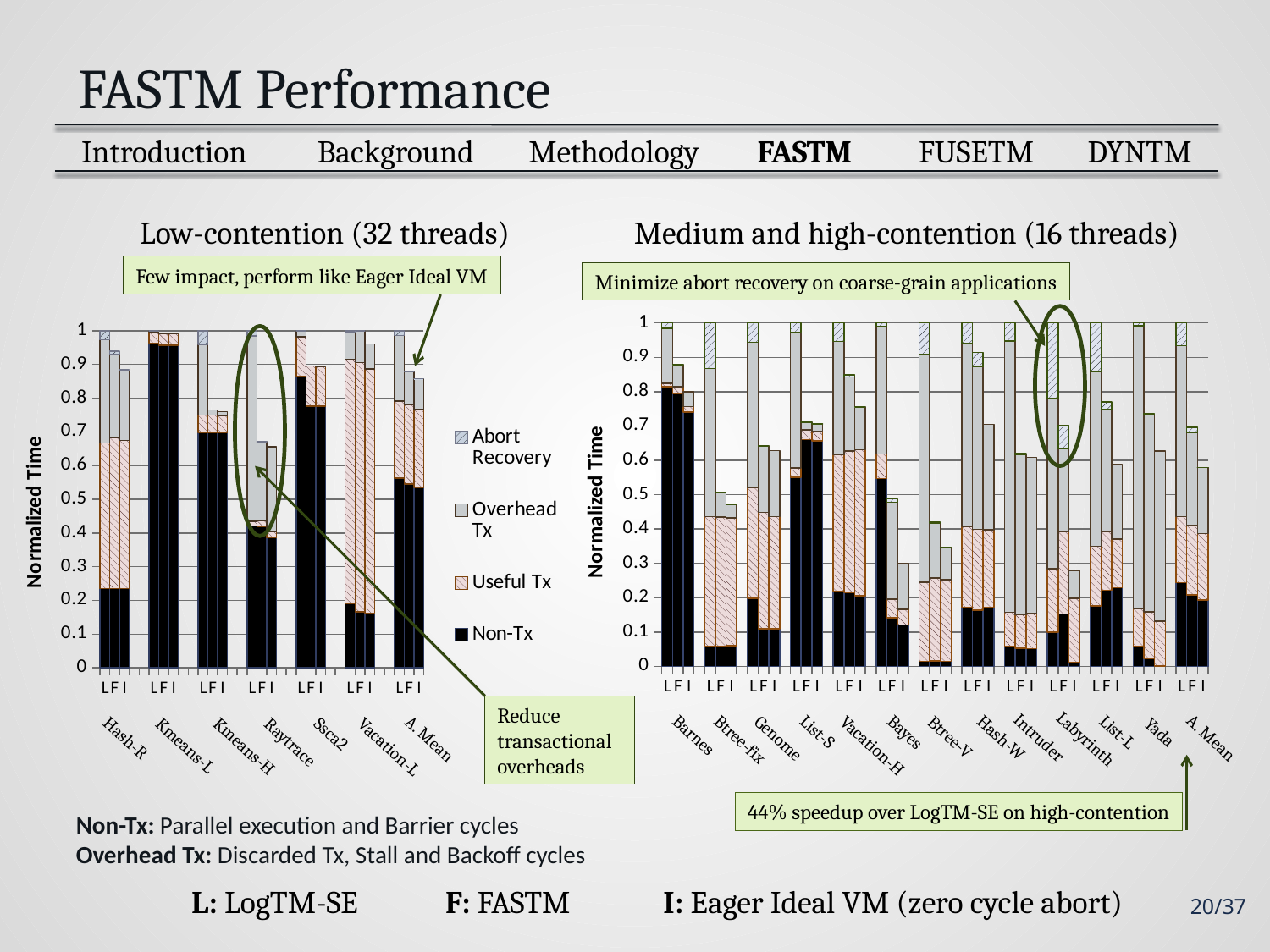
In the Low-contention (32 threads) chart, is the Non-Tx value of the L bar for Vacation-L greater or less than 0.3? less In the Medium and high-contention (16 threads) chart, is the total height of the F bar for Labyrinth greater or less than 0.5? greater In the Low-contention (32 threads) chart, is the Non-Tx value of the L bar for Kmeans-L greater or less than 0.9? greater What kind of chart is the Low-contention (32 threads) chart? Stacked bar chart How many benchmark categories are shown on the x axis of the Low-contention (32 threads) chart? 7 In the Medium and high-contention (16 threads) chart, which is taller: the F bar for Labyrinth or the F bar for Yada? Yada How many benchmark categories are shown on the x axis of the Medium and high-contention (16 threads) chart? 13 What is the y-axis title of the Medium and high-contention (16 threads) chart? Normalized Time In the Low-contention (32 threads) chart, which benchmark has the highest Non-Tx value in its L bar? Kmeans-L How many series does the legend of the Low-contention (32 threads) chart list? 4